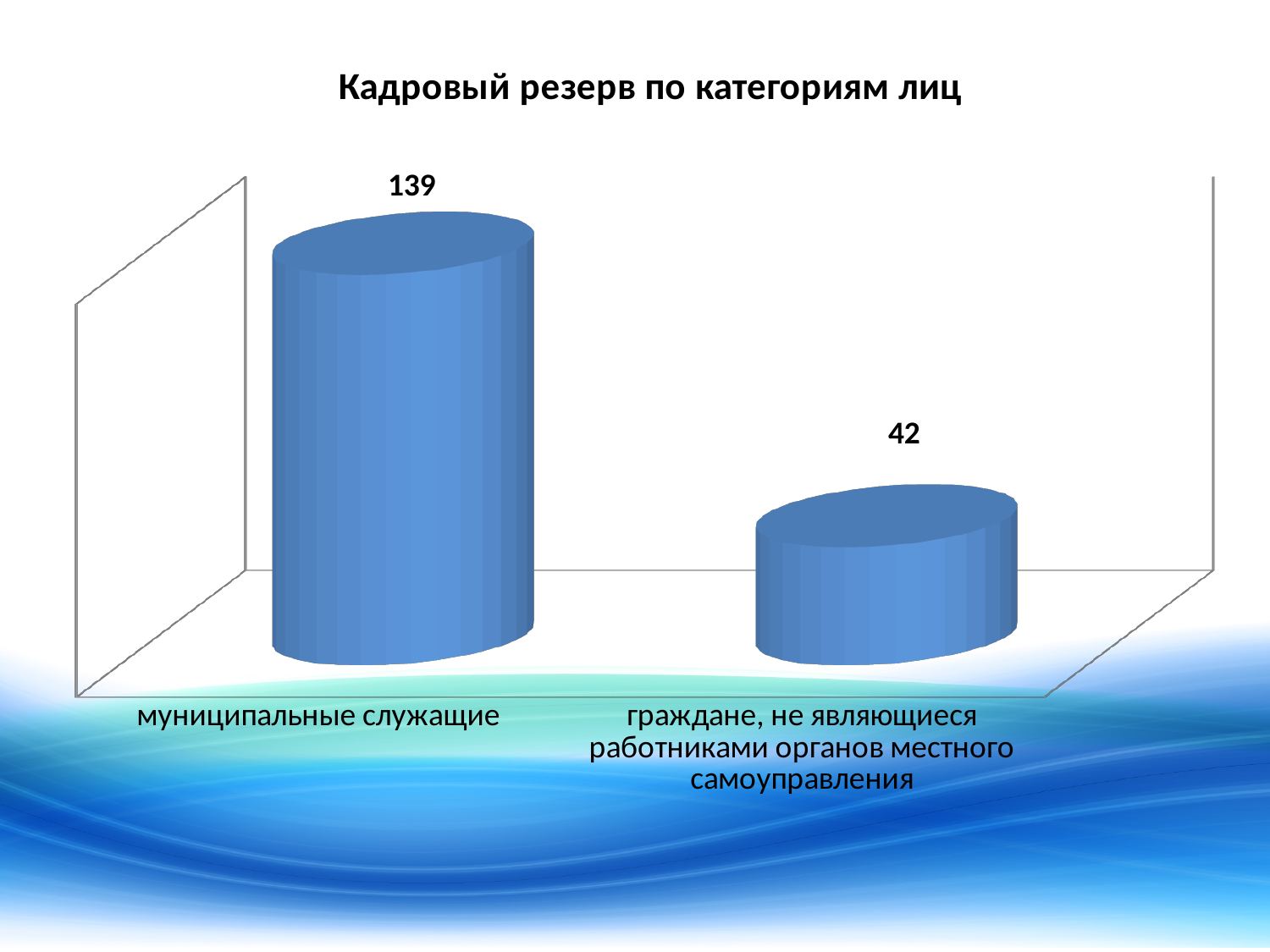
What kind of chart is shown on the slide? bar chart Which category has the lowest value? граждане, не являющиеся работниками органов местного самоуправления What is the total of the two values shown in the chart? 181 What is the value for граждане, не являющиеся работниками органов местного самоуправления? 42 Which is larger: the value for муниципальные служащие or the value for граждане, не являющиеся работниками органов местного самоуправления? муниципальные служащие What is the title of the chart? Кадровый резерв по категориям лиц What is the difference between the values for муниципальные служащие and граждане, не являющиеся работниками органов местного самоуправления? 97 What is the value for муниципальные служащие? 139 What colour are the bars in the chart? blue Which category has the highest value? муниципальные служащие How many categories are shown in the chart? 2